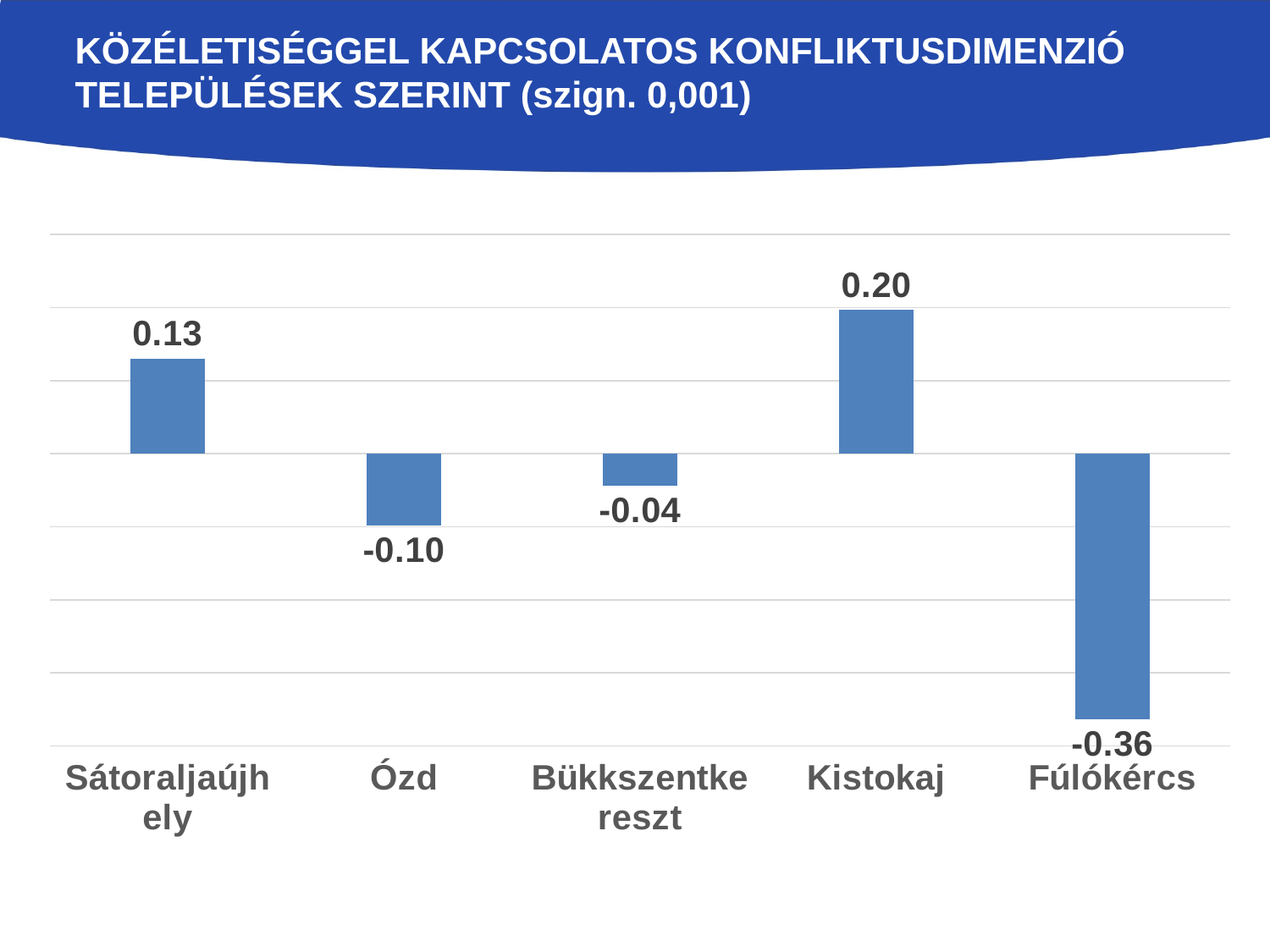
How many settlements are shown in the chart? 5 What is the value for Bükkszentkereszt? -0.04 What is the value for Kistokaj? 0.20 What is the value for Fúlókércs? -0.36 What is the difference between the values for Kistokaj and Sátoraljaújhely? 0.07 What is the value for Ózd? -0.10 How many settlements have a negative value? 3 Which settlement has the highest value? Kistokaj What is the difference between the values for Ózd and Fúlókércs? 0.26 Which has a larger value, Sátoraljaújhely or Ózd? Sátoraljaújhely Which settlement has the lowest value? Fúlókércs What kind of chart is shown on the slide? Bar chart